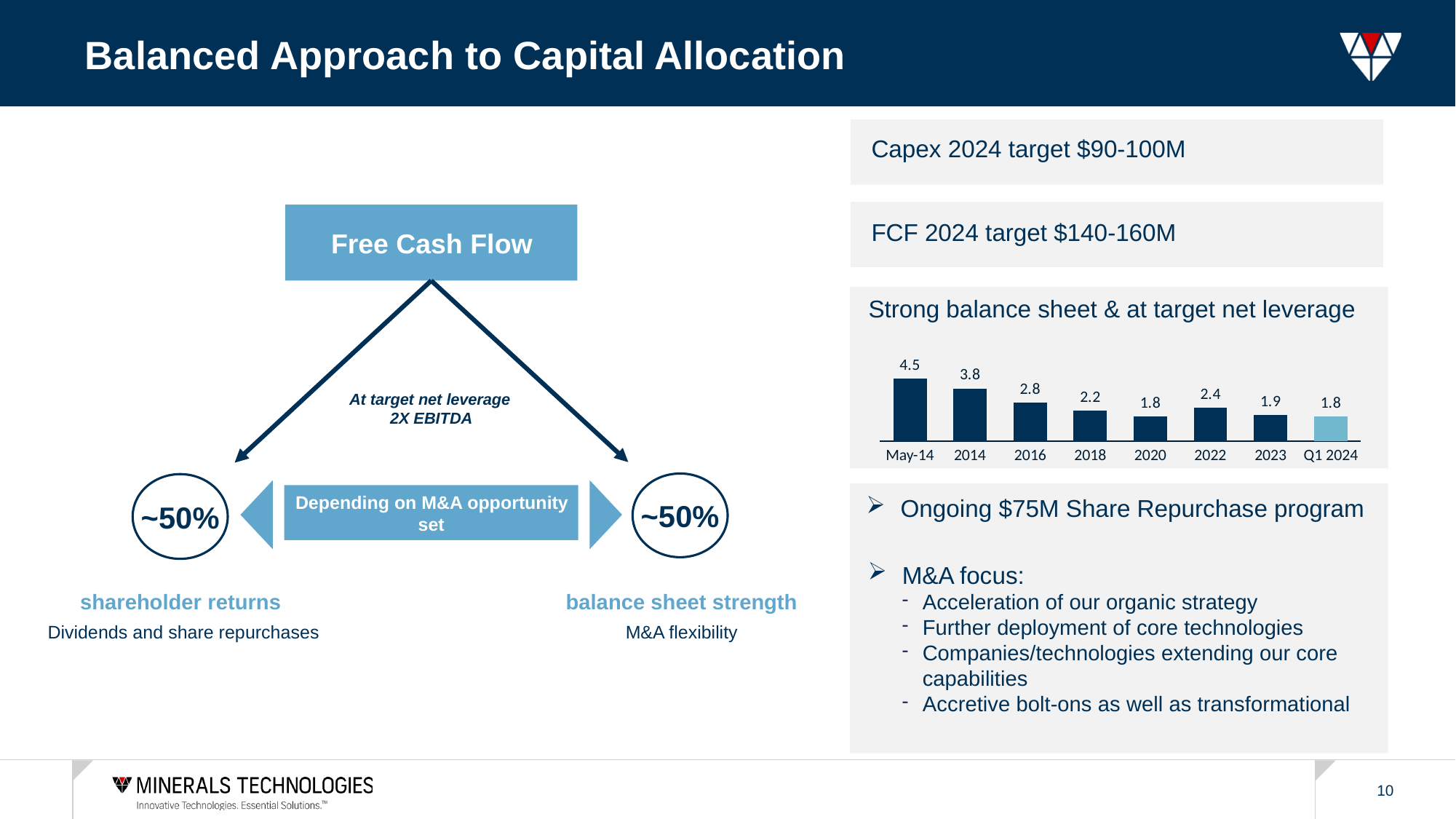
What is the net leverage value shown for 2018 in the bar chart? 2.2 What is the net leverage value shown for Q1 2024 in the bar chart? 1.8 What is the title above the net leverage bar chart? Strong balance sheet & at target net leverage Which has a higher net leverage value, 2020 or 2023? 2023 What is the net leverage value shown for May-14 in the bar chart? 4.5 What kind of chart is used to show net leverage on the slide? Bar chart What is the difference between the net leverage values for 2022 and 2023? 0.5 Which has a higher net leverage value, 2016 or 2022? 2016 What is the difference between the net leverage values for May-14 and 2014? 0.7 Which period has the highest net leverage value in the bar chart? May-14 How many periods (bars) are shown in the net leverage bar chart? 8 What is the net leverage value shown for 2022 in the bar chart? 2.4